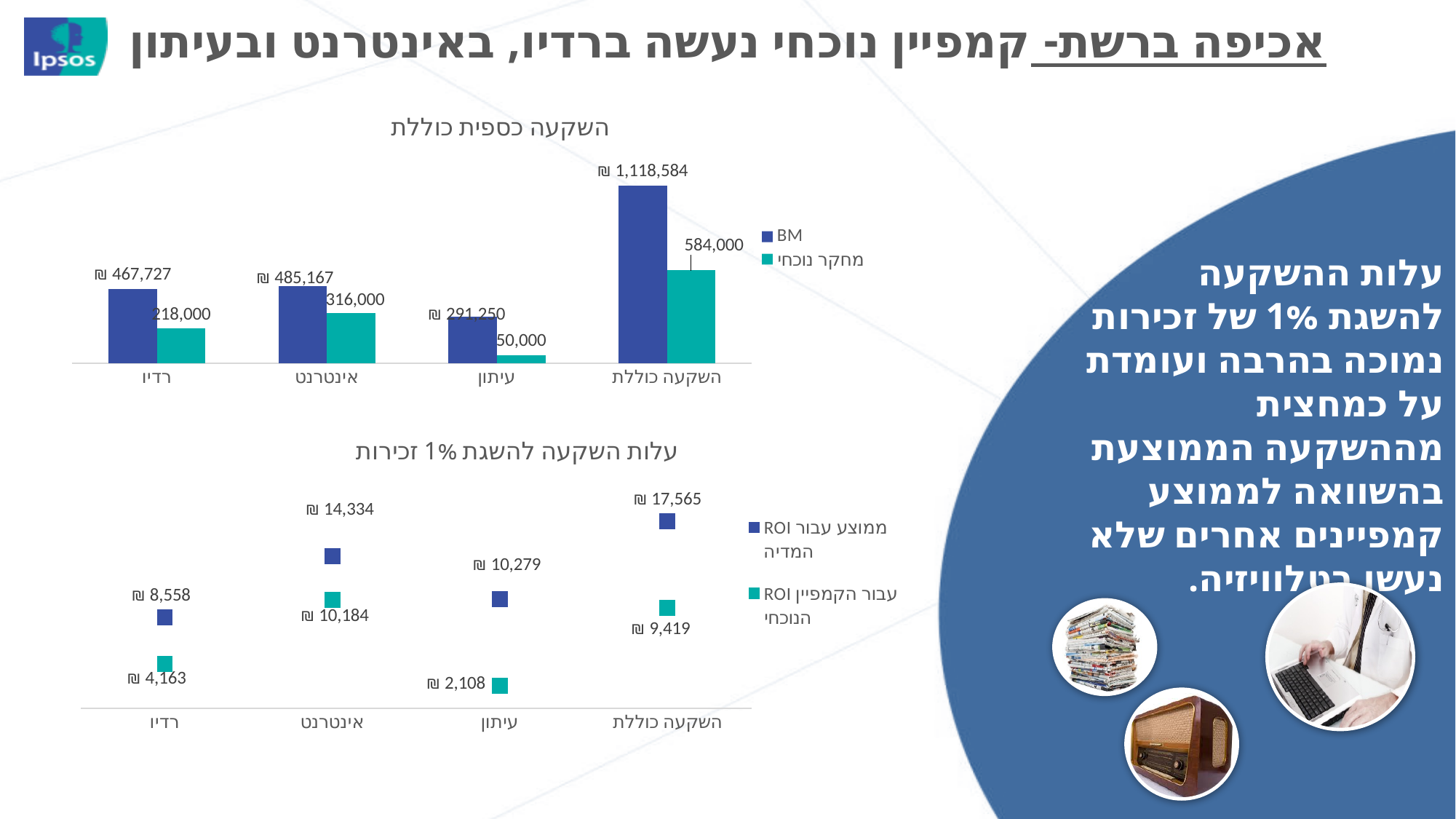
In the bottom chart (עלות השקעה להשגת 1% זכירות), which is larger for רדיו: ROI ממוצע עבור המדיה or ROI עבור הקמפיין הנוכחי? ROI ממוצע עבור המדיה In the top chart (השקעה כספית כוללת), what is the מחקר נוכחי value for אינטרנט? 316,000 In the top chart (השקעה כספית כוללת), which category has the lowest מחקר נוכחי value? עיתון In the bottom chart (עלות השקעה להשגת 1% זכירות), how many categories are shown on the x axis? 4 In the bottom chart (עלות השקעה להשגת 1% זכירות), which category has the highest ROI ממוצע עבור המדיה value? השקעה כוללת In the top chart (השקעה כספית כוללת), what is the BM value for רדיו? ₪ 467,727 In the top chart (השקעה כספית כוללת), what is the difference between the BM value and the מחקר נוכחי value for השקעה כוללת? 534,584 In the bottom chart (עלות השקעה להשגת 1% זכירות), what is the ROI עבור הקמפיין הנוכחי value for עיתון? ₪ 2,108 In the top chart (השקעה כספית כוללת), how many series does the legend list? 2 In the top chart (השקעה כספית כוללת), what kind of chart is shown? Bar chart In the top chart (השקעה כספית כוללת), which category has the highest BM value? השקעה כוללת In the bottom chart (עלות השקעה להשגת 1% זכירות), what is the ROI ממוצע עבור המדיה value for אינטרנט? ₪ 14,334